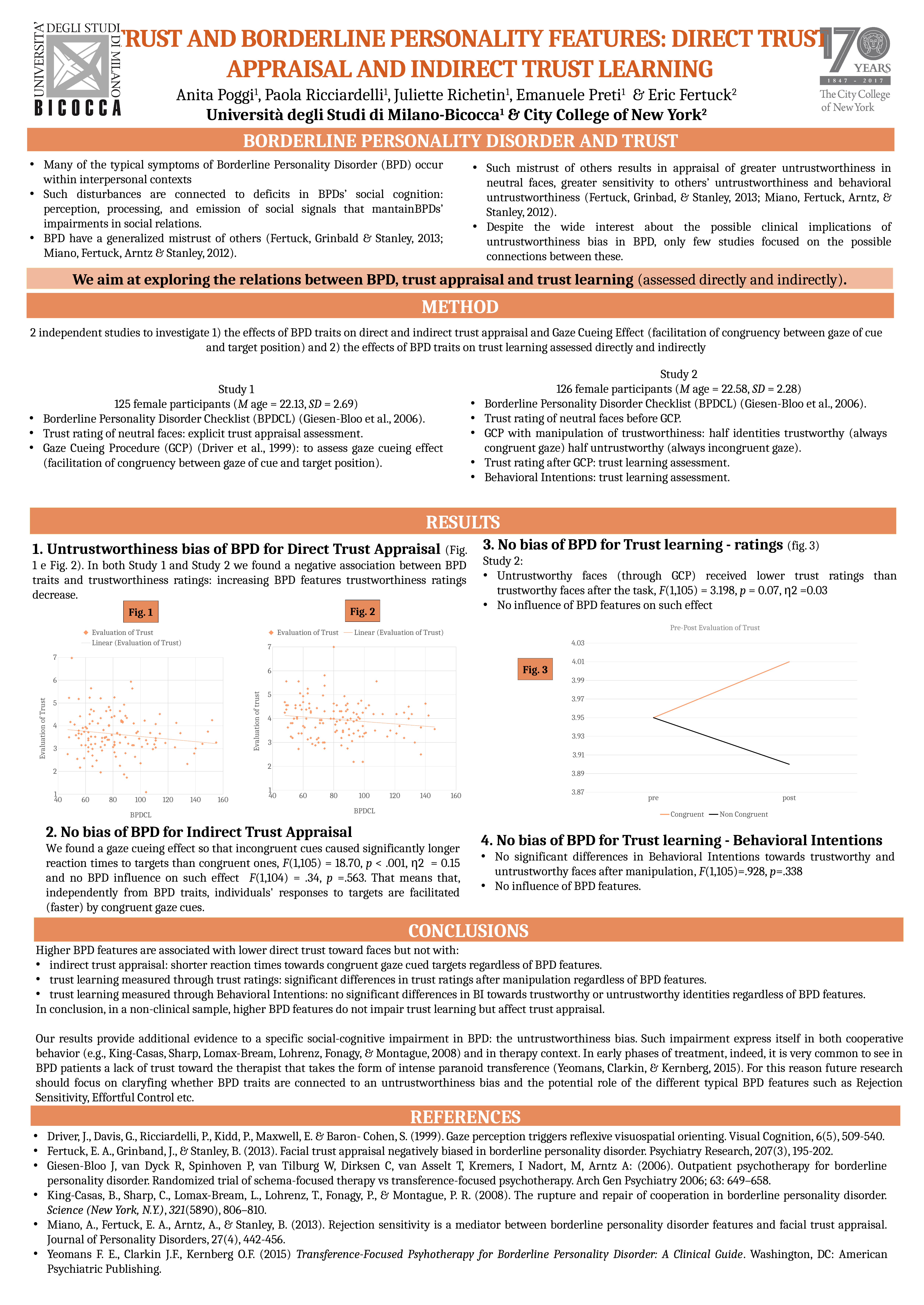
In Fig. 3 (Pre-Post Evaluation of Trust), does the Non Congruent series rise or fall from pre to post? Falls In Fig. 3 (Pre-Post Evaluation of Trust), at post, which series is higher: Congruent or Non Congruent? Congruent In Fig. 2, does the linear trend line rise or fall as BPDCL increases? Falls What kind of chart is Fig. 3 (Pre-Post Evaluation of Trust)? Line chart What kind of chart is Fig. 1? Scatter chart In Fig. 3 (Pre-Post Evaluation of Trust), how many series does the legend list? 2 In Fig. 3 (Pre-Post Evaluation of Trust), is the Non Congruent value at post greater or less than 3.93? less In Fig. 3 (Pre-Post Evaluation of Trust), is the Congruent value at post greater or less than 3.99? greater In Fig. 3 (Pre-Post Evaluation of Trust), does the Congruent series rise or fall from pre to post? Rises In Fig. 3 (Pre-Post Evaluation of Trust), how many categories are on the x axis? 2 What is the x-axis label of Fig. 1? BPDCL